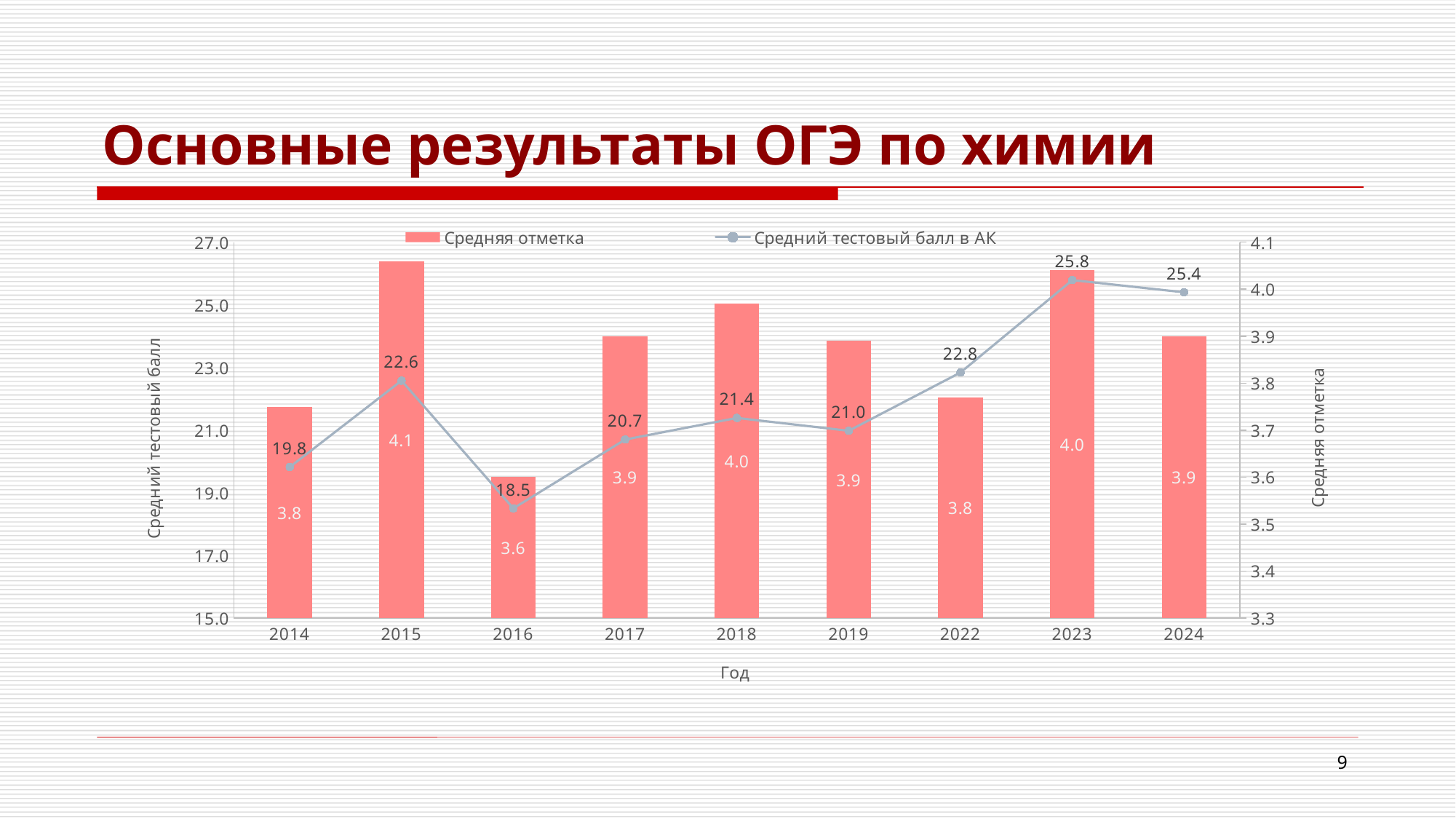
Which year has a higher Средний тестовый балл в АК, 2015 or 2022? 2022 What is the value of Средний тестовый балл в АК for 2016? 18.5 What is the difference between the Средний тестовый балл в АК values for 2023 and 2016? 7.3 What kind of chart is shown on the slide? Combined bar and line chart How many years are shown on the x axis? 9 How many series does the legend list? 2 In which year is Средний тестовый балл в АК the lowest? 2016 In which year is Средний тестовый балл в АК the highest? 2023 Does Средний тестовый балл в АК rise or fall from 2019 to 2023? Rise In which year is Средняя отметка the lowest? 2016 What is the value of Средний тестовый балл в АК for 2024? 25.4 What is the value of Средняя отметка for 2015? 4.1